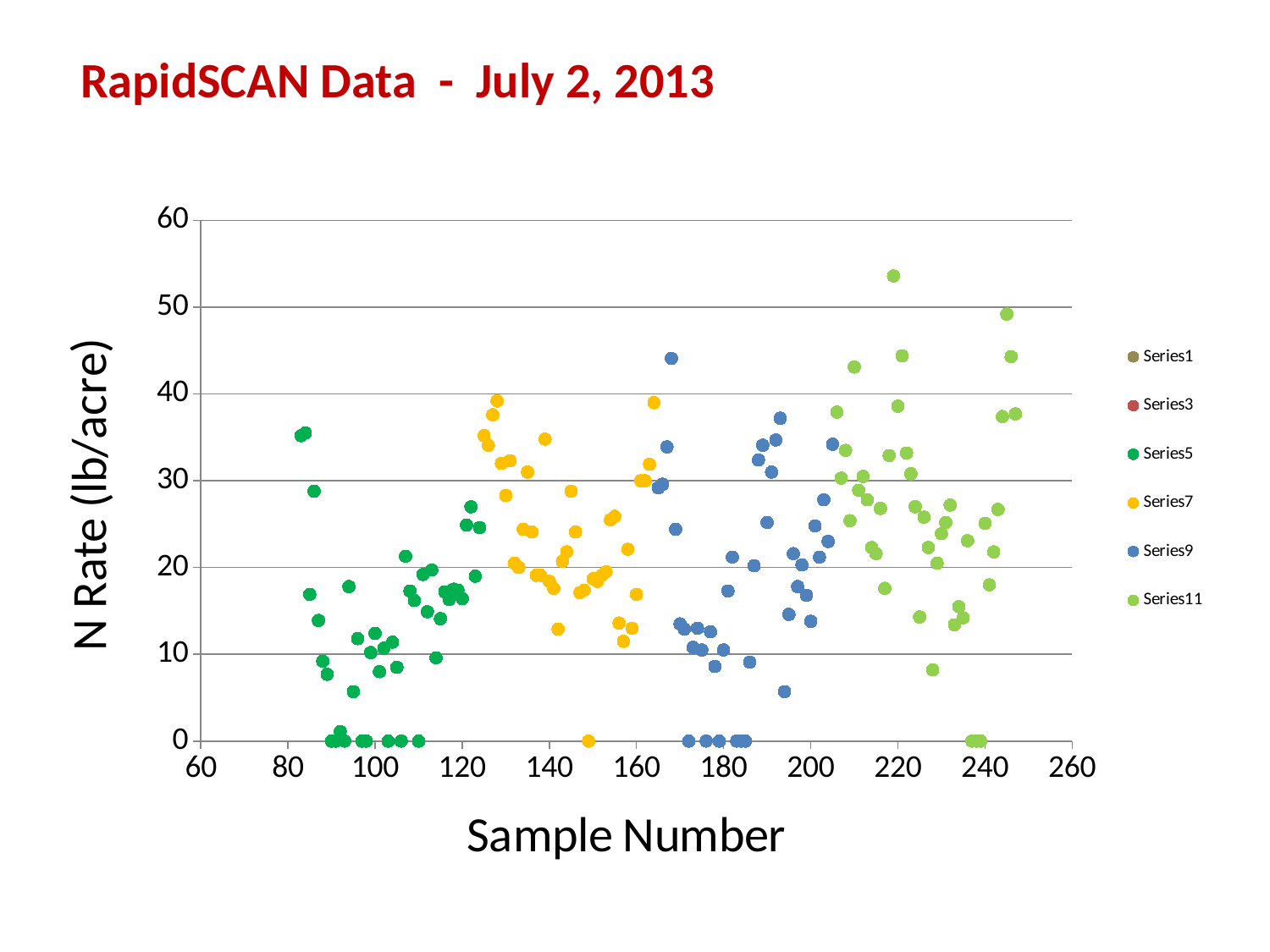
Which series contains the highest plotted point on the chart? Series11 Is the highest point in Series9 greater or less than 40? greater What is the title of the chart on the slide? RapidSCAN Data - July 2, 2013 What is the label on the vertical axis? N Rate (lb/acre) What kind of chart is shown on the slide? Scatter chart Is the highest point in Series5 greater or less than 30? greater How many series does the legend list? 6 Is the highest point in Series11 greater or less than 50? greater Which series has a higher maximum point, Series9 or Series11? Series11 Which series has a higher maximum point, Series5 or Series9? Series9